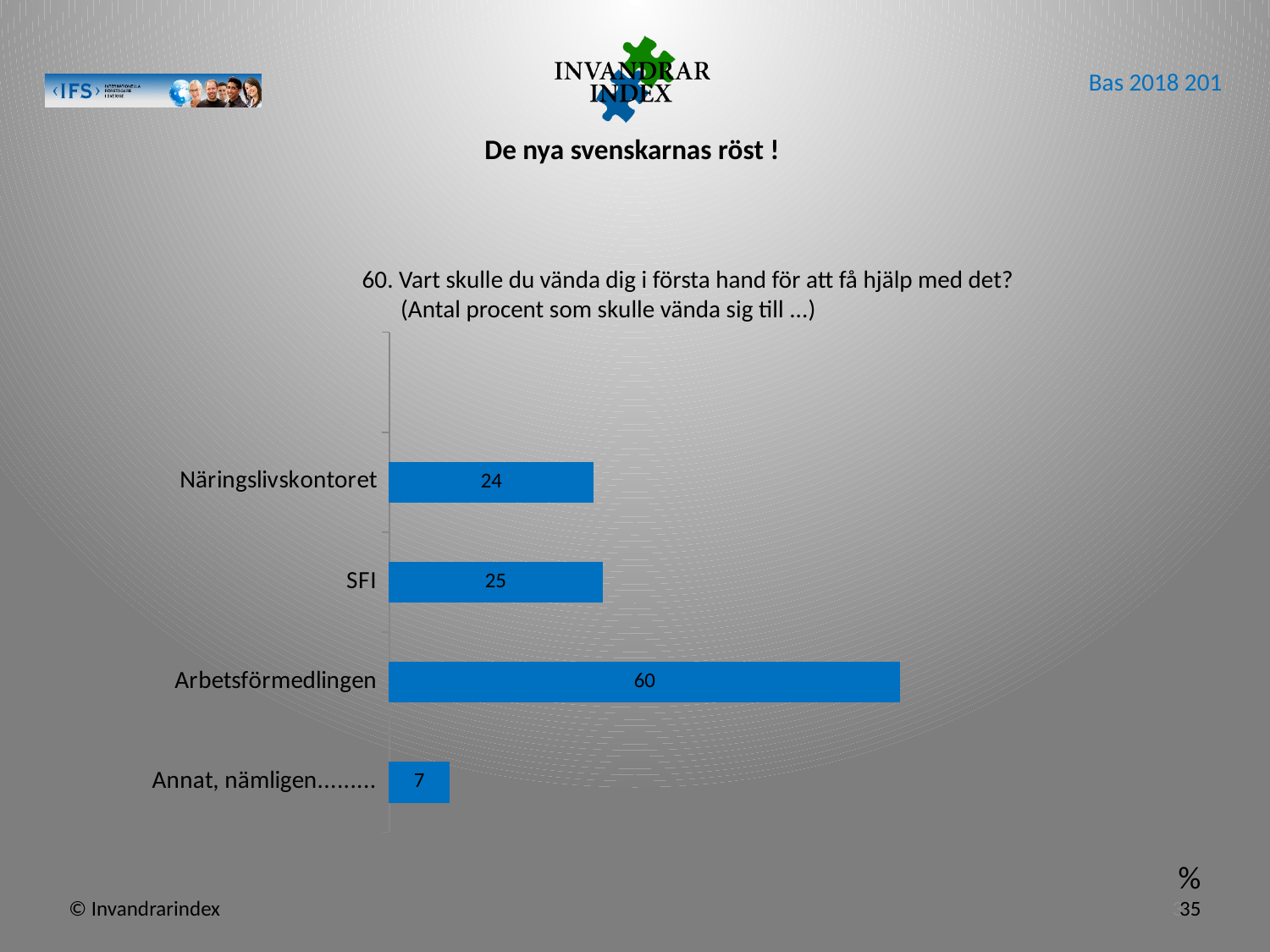
How many categories are shown in the chart? 4 Which category has the highest value? Arbetsförmedlingen Which category has the lowest value? Annat, nämligen......... Which is larger, the value for Arbetsförmedlingen or the value for Näringslivskontoret? Arbetsförmedlingen What is the value for Arbetsförmedlingen? 60 What is the question number shown in the chart title? 60 What kind of chart is shown on the slide? bar chart What is the value for SFI? 25 What is the difference between the values for Arbetsförmedlingen and SFI? 35 What is the difference between the values for SFI and Näringslivskontoret? 1 What is the value for Näringslivskontoret? 24 What is the value for Annat, nämligen.........? 7